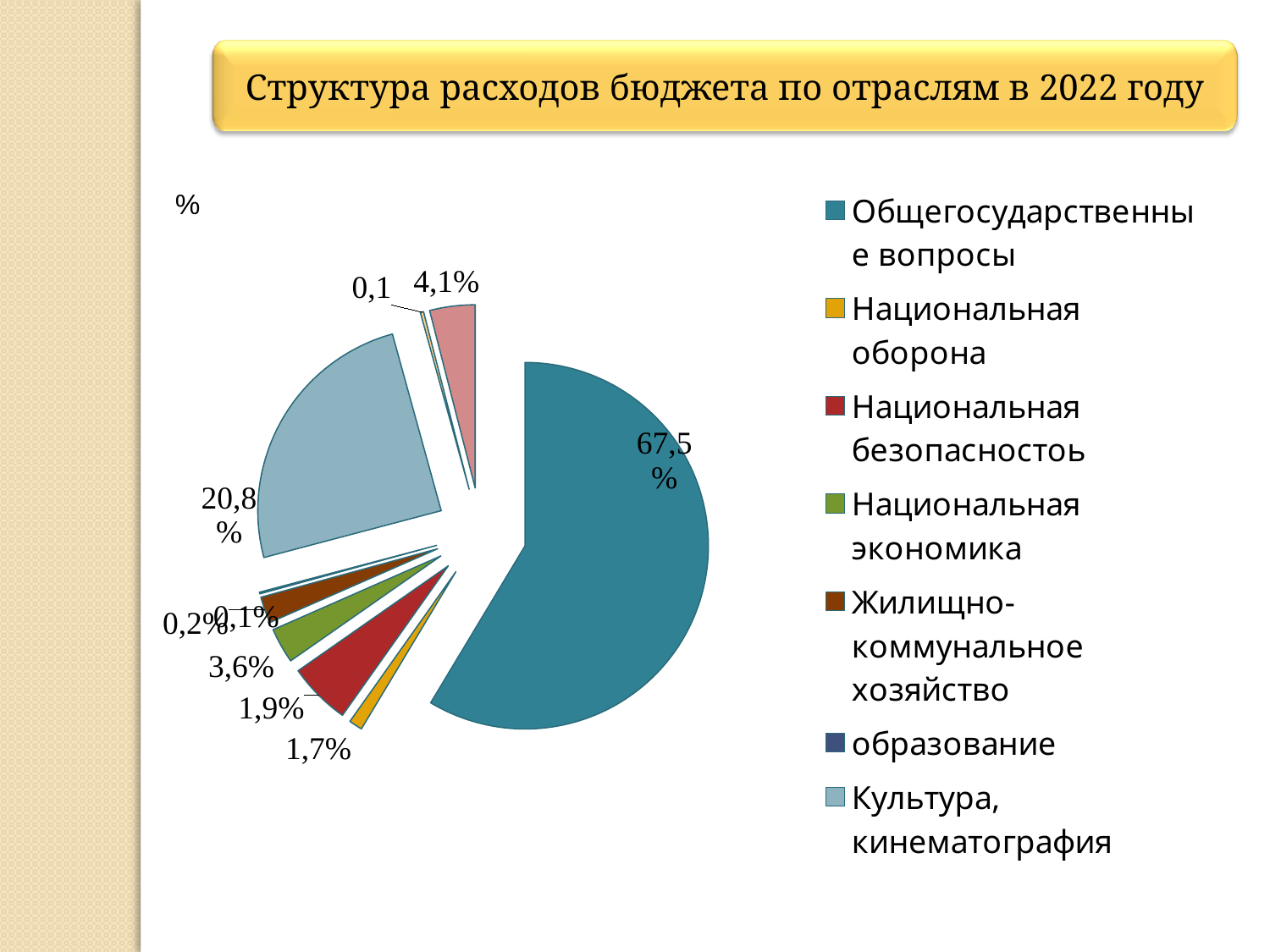
What is the value for Национальная экономика? 3,6% What kind of chart is shown on the slide? pie chart What share of the pie does Общегосударственные вопросы take? 67,5% How many entries does the legend list? 7 Which category has the largest slice of the pie? Общегосударственные вопросы What is the value for Национальная безопасность? 1,9% Which is larger, Национальная безопасность or Национальная оборона? Национальная безопасность What is the difference between the shares of Общегосударственные вопросы and Культура, кинематография? 46,7% What is the title of the chart? Структура расходов бюджета по отраслям в 2022 году Which is larger, Национальная экономика or Национальная оборона? Национальная экономика What is the value for Национальная оборона? 1,7% What share of the pie does Культура, кинематография take? 20,8%